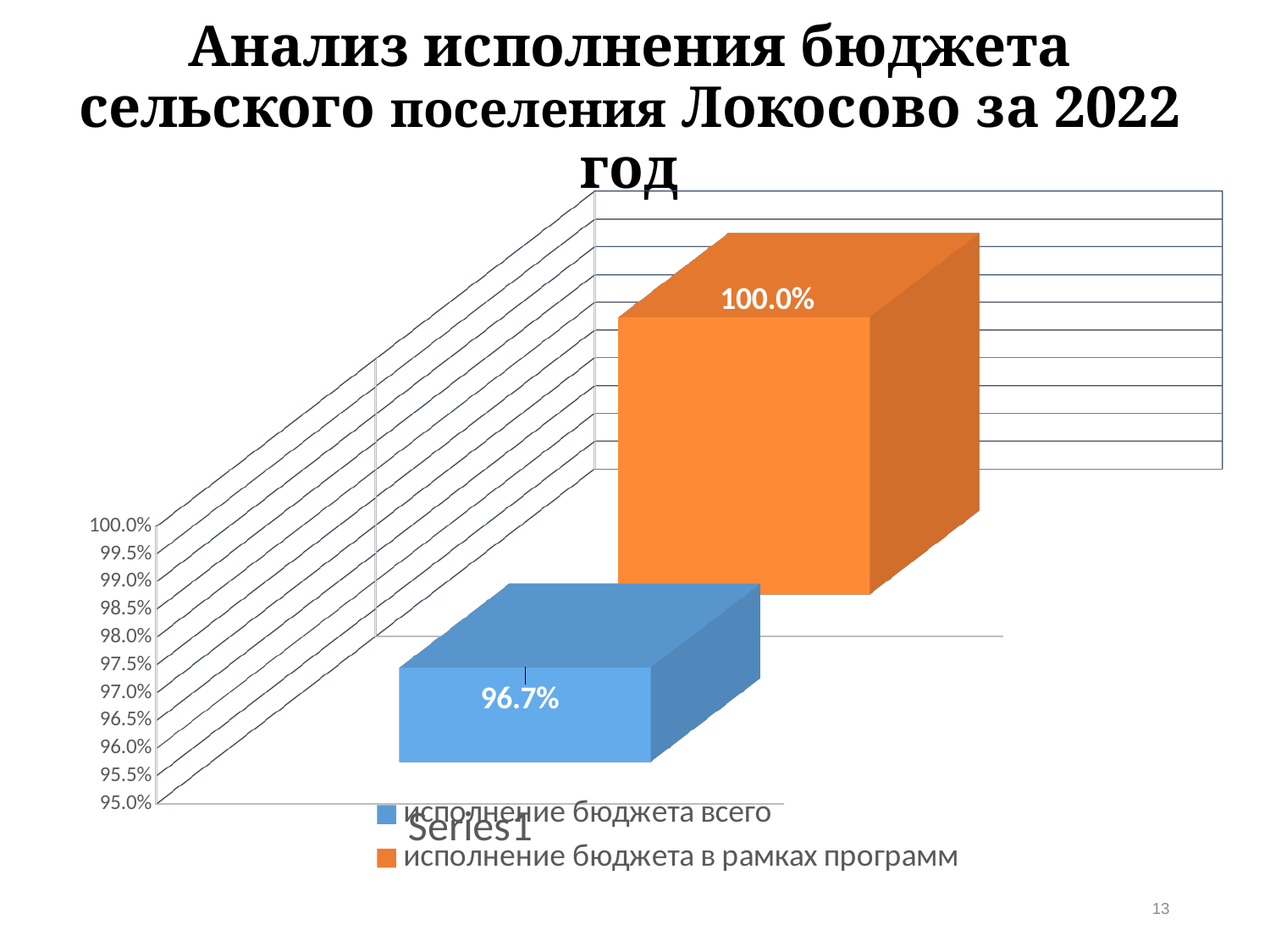
Which series has the lower value? исполнение бюджета всего Which series has the higher value? исполнение бюджета в рамках программ What is the lowest value shown on the vertical axis? 95.0% Is the value for "исполнение бюджета всего" greater or less than 98.0%? less What is the value for "исполнение бюджета всего"? 96.7% What is the value for "исполнение бюджета в рамках программ"? 100.0% What is the difference between the value for "исполнение бюджета в рамках программ" and the value for "исполнение бюджета всего"? 3.3% Is the value for "исполнение бюджета всего" larger or smaller than the value for "исполнение бюджета в рамках программ"? smaller What colour is the bar for "исполнение бюджета в рамках программ"? orange How many series does the legend list? 2 What kind of chart is shown on the slide? bar chart